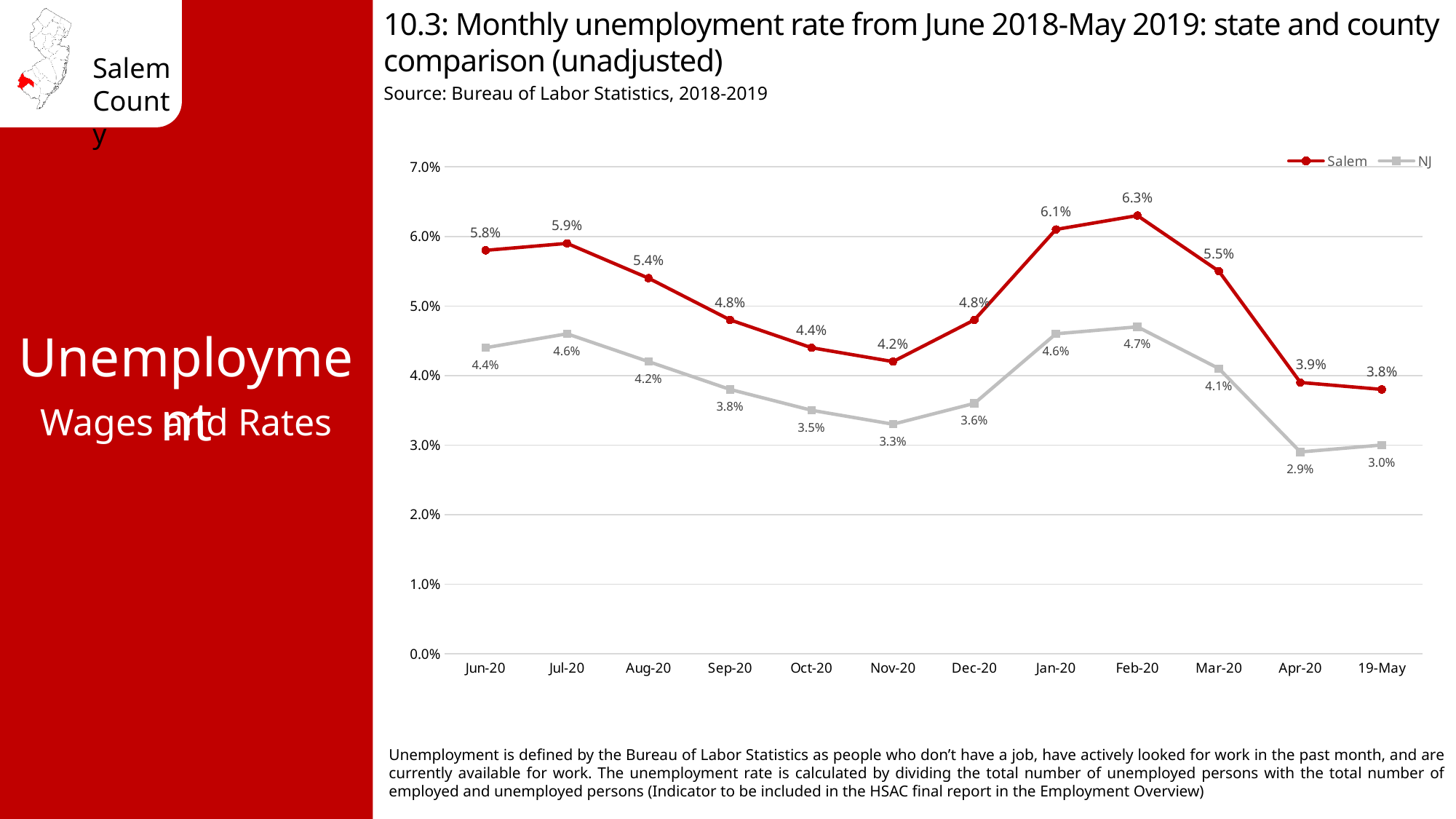
What colour is the Salem line? Red In which month does the NJ series reach its lowest value? Apr-20 Which series has the higher value in Sep-20, Salem or NJ? Salem What is the NJ unemployment rate for Apr-20? 2.9% What kind of chart is shown on the slide? Line chart How many months are plotted on the x axis? 12 What is the NJ unemployment rate for Nov-20? 3.3% Does the Salem series rise or fall from Jul-20 to Nov-20? Fall In which month does the Salem series reach its highest value? Feb-20 What is the Salem unemployment rate for Feb-20? 6.3% What is the difference between the Salem and NJ rates in Jan-20? 1.5% How many series does the legend list? 2